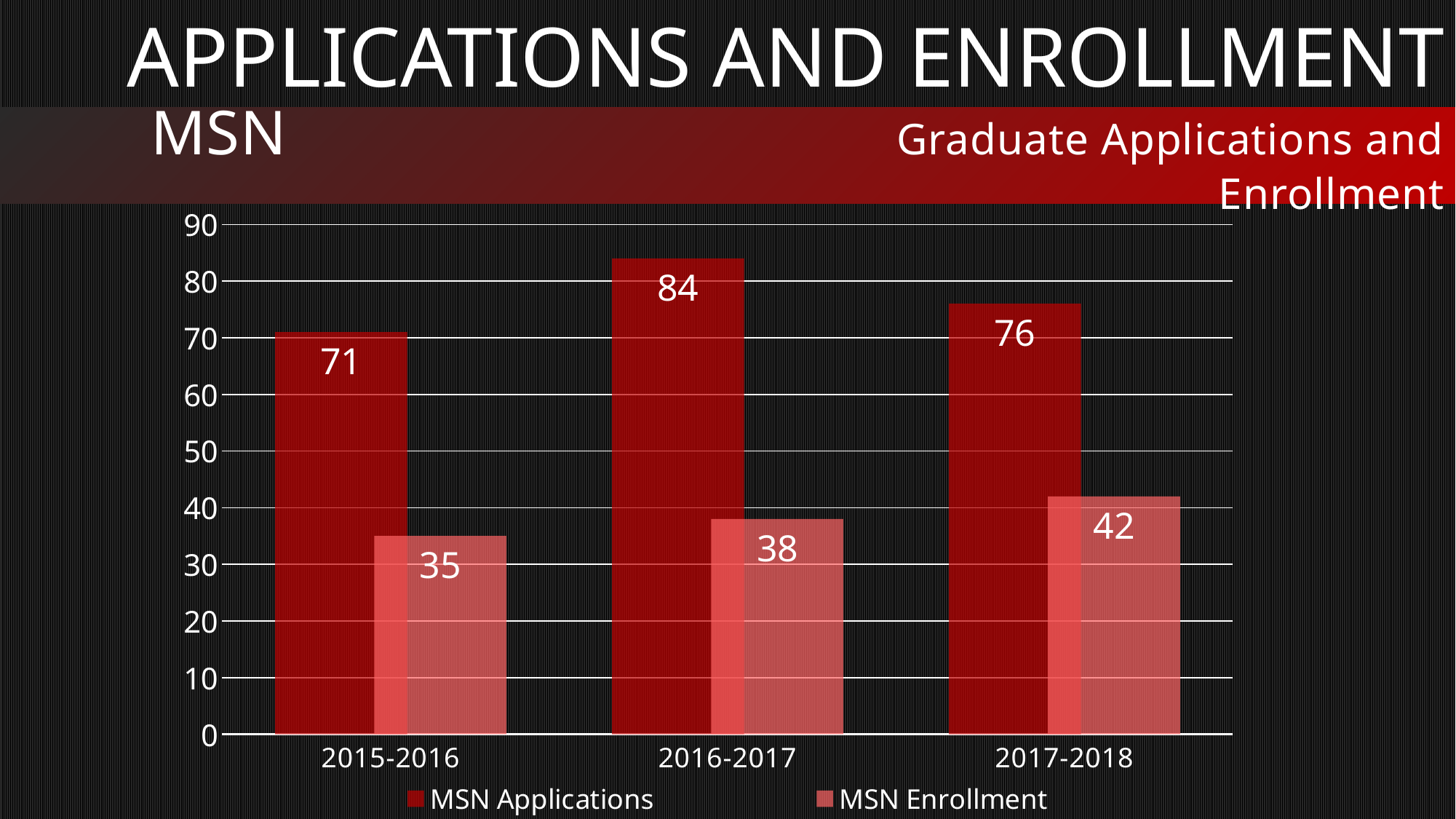
Does MSN Enrollment rise or fall from 2015-2016 to 2017-2018? rise What kind of chart is shown on the slide? bar chart What is the value of MSN Enrollment for 2017-2018? 42 Is the value for MSN Enrollment in 2016-2017 greater or less than 40? less Which year has the highest MSN Applications value? 2016-2017 What is the value of MSN Applications for 2016-2017? 84 Which year has the lowest MSN Enrollment value? 2015-2016 How many academic years are shown on the x axis? 3 Which is larger: MSN Applications in 2015-2016 or MSN Applications in 2017-2018? 2017-2018 What is the value of MSN Enrollment for 2015-2016? 35 How many series does the legend list? 2 What is the difference between MSN Applications and MSN Enrollment in 2017-2018? 34